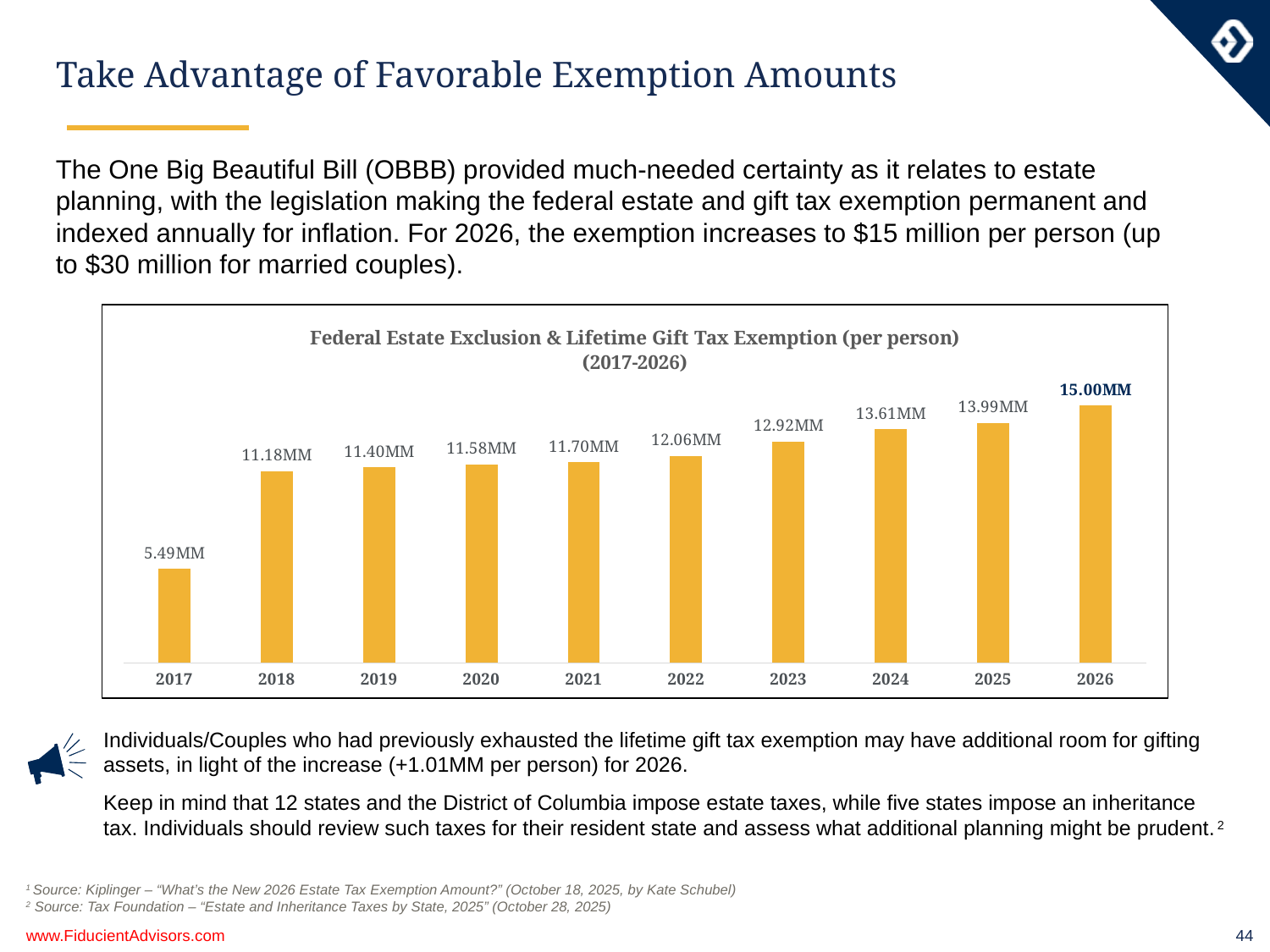
What is the title of the chart? Federal Estate Exclusion & Lifetime Gift Tax Exemption (per person) (2017-2026) What is the difference between the values for 2026 and 2025? 1.01MM What is the value for 2022? 12.06MM What is the value for 2026? 15.00MM What is the difference between the values for 2018 and 2017? 5.69MM Which year has the highest value? 2026 What is the value for 2017? 5.49MM Which is larger, the value for 2023 or the value for 2021? 2023 What kind of chart is this? Bar chart Which year has the lowest value? 2017 Do the values rise or fall from 2017 to 2026? Rise How many years are shown on the x axis? 10